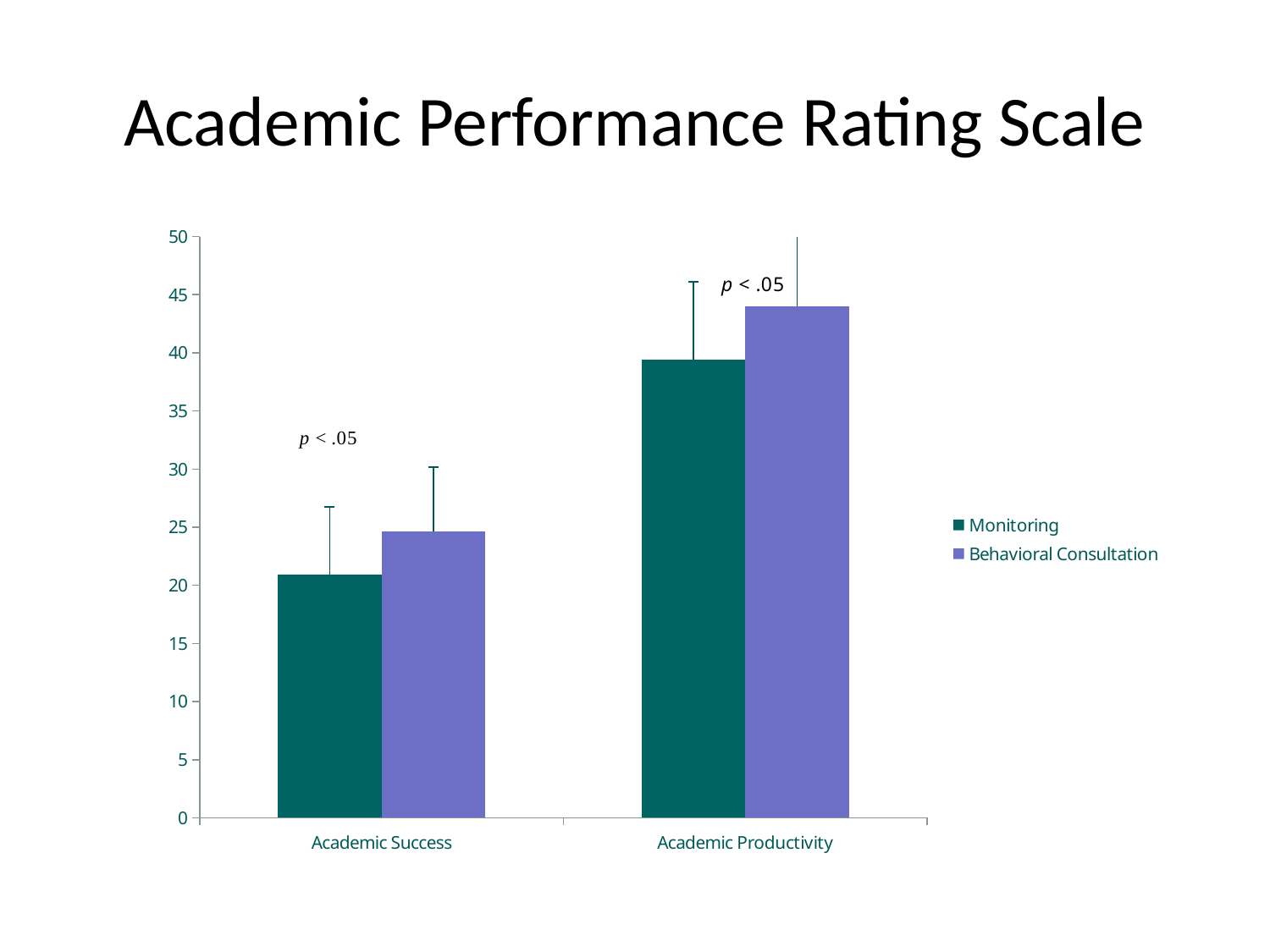
Which category has the lowest Monitoring value? Academic Success Is the Behavioral Consultation value for Academic Productivity greater or less than 40? greater Which category has the highest Behavioral Consultation value? Academic Productivity How many series does the legend list? 2 For Academic Success, which is larger: Monitoring or Behavioral Consultation? Behavioral Consultation What kind of chart is shown on the slide? bar chart Is the Monitoring value for Academic Success greater or less than 25? less Which series is shown in purple? Behavioral Consultation What is the title of the chart? Academic Performance Rating Scale Is the Monitoring value for Academic Productivity greater or less than 35? greater How many categories are shown on the x axis? 2 For Academic Productivity, which is larger: Monitoring or Behavioral Consultation? Behavioral Consultation